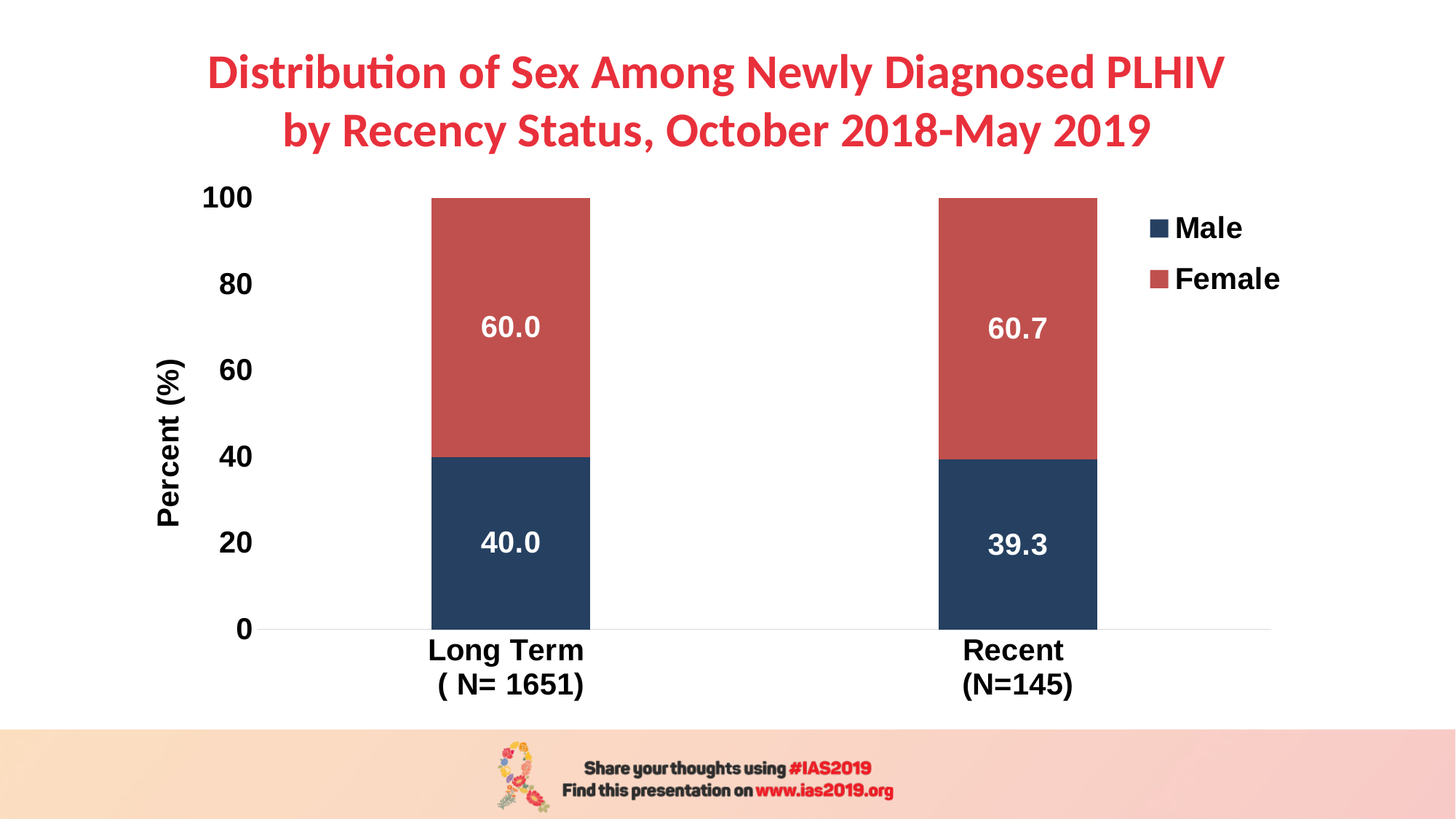
What is the Female value for Recent? 60.7 Is the Male value for Long Term larger or smaller than the Female value for Long Term? smaller How many categories are shown on the x axis? 2 What is the difference between the Female and Male values for Long Term? 20.0 How many series does the legend list? 2 What kind of chart is shown on the slide? stacked bar chart What is the Male value for Long Term? 40.0 What is the Female value for Long Term? 60.0 What is the difference between the Female values for Recent and Long Term? 0.7 Which category has the lower Male value? Recent Which category has the higher Female value? Recent What is the Male value for Recent? 39.3